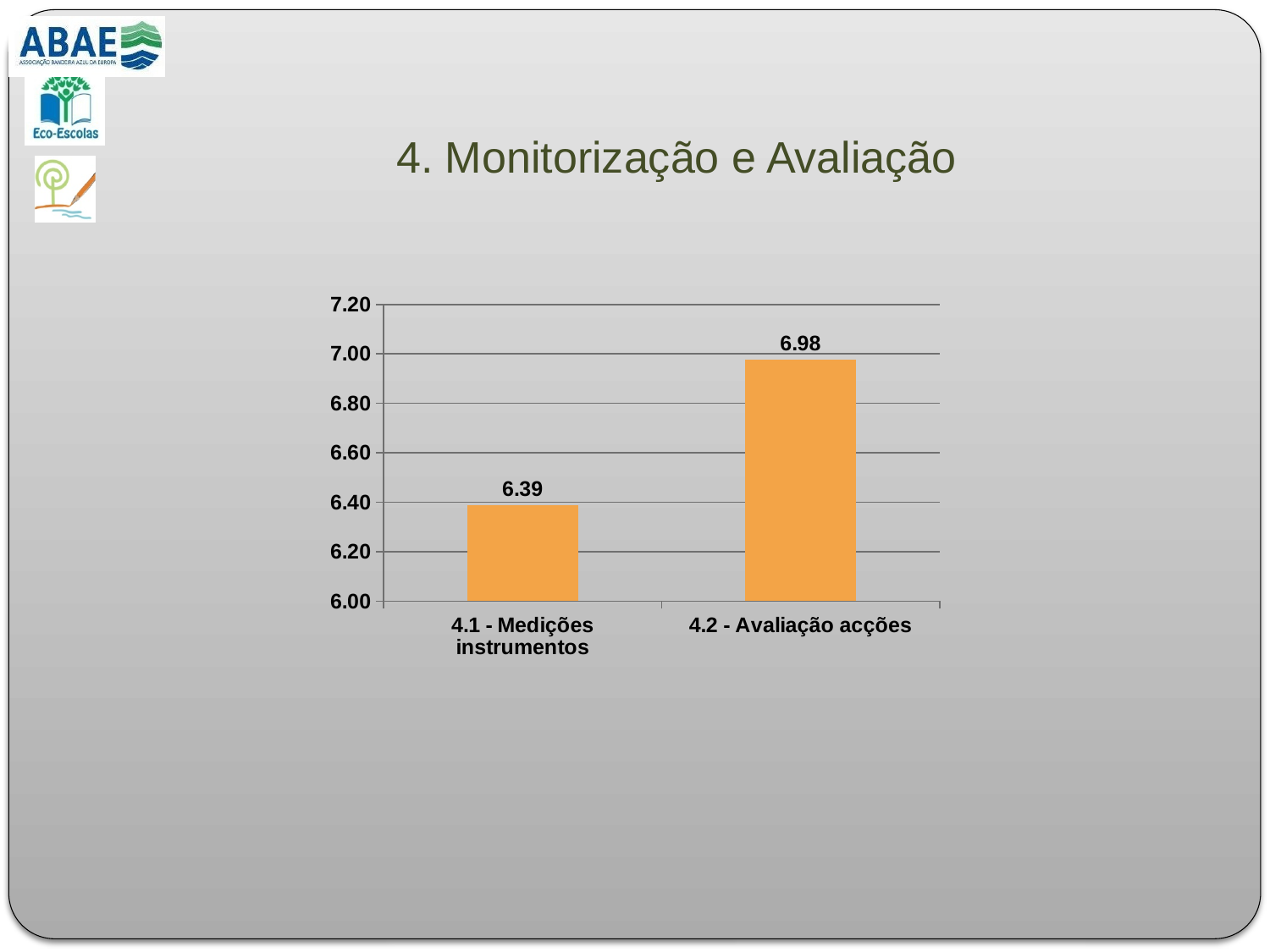
What is the difference between the values for 4.2 - Avaliação acções and 4.1 - Medições instrumentos? 0.59 What is the value for 4.2 - Avaliação acções? 6.98 Which category has the highest value? 4.2 - Avaliação acções Which category has the lowest value? 4.1 - Medições instrumentos Which is larger, the value for 4.1 - Medições instrumentos or the value for 4.2 - Avaliação acções? 4.2 - Avaliação acções Is the value for 4.2 - Avaliação acções greater or less than 6.80? greater Do the values rise or fall from left to right along the x axis? rise How many categories are shown in the chart? 2 Is the value for 4.1 - Medições instrumentos greater or less than 6.60? less What is the value for 4.1 - Medições instrumentos? 6.39 What kind of chart is shown on the slide? bar chart What is the title of the slide containing the chart? 4. Monitorização e Avaliação